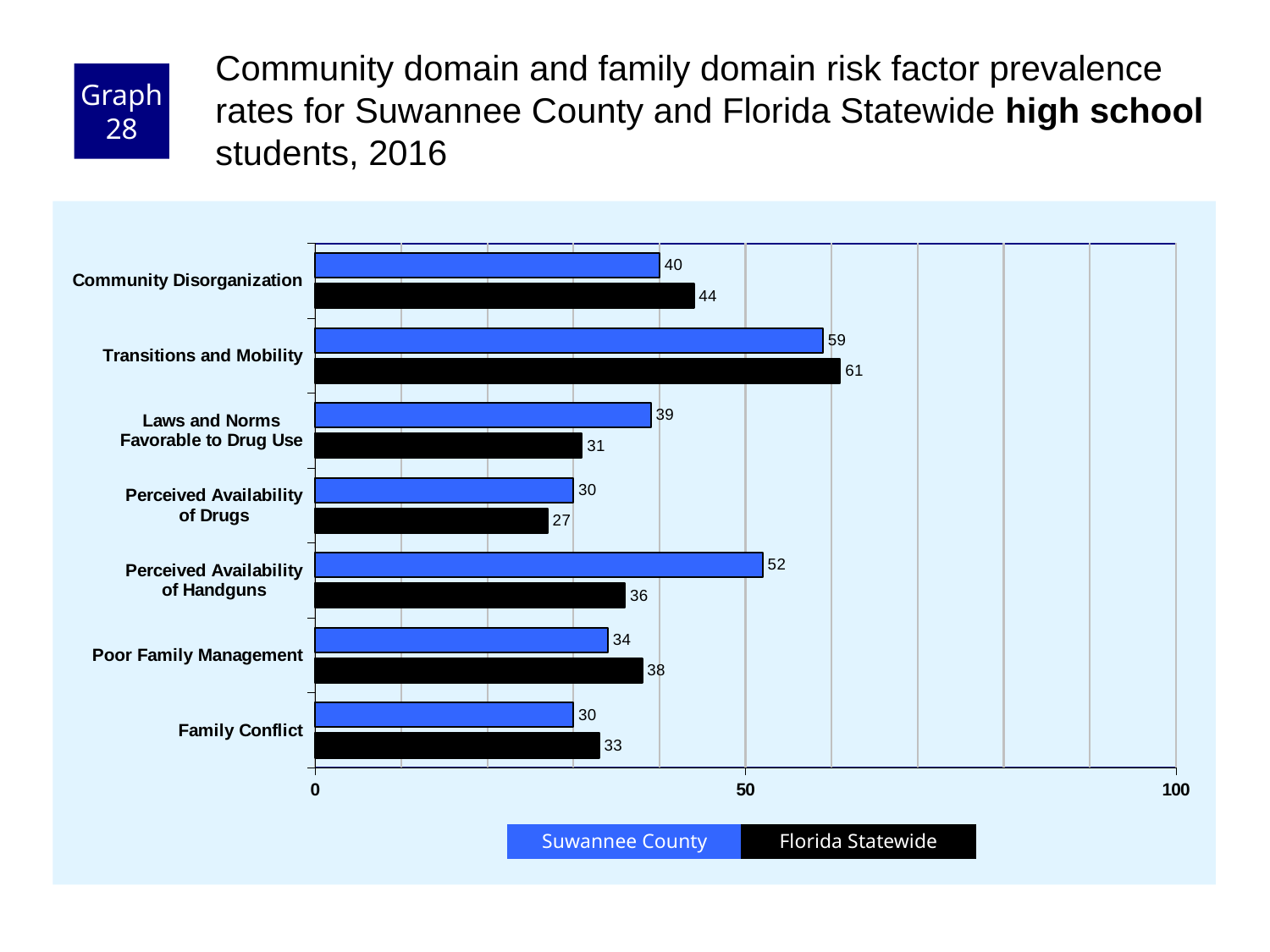
Which risk factor has the highest Florida Statewide value? Transitions and Mobility What kind of chart is shown on the slide? Bar chart How many series does the legend list? 2 What is the Florida Statewide value for Community Disorganization? 44 How many risk factors are shown on the chart? 7 What is the Florida Statewide value for Perceived Availability of Handguns? 36 Is the Suwannee County value for Transitions and Mobility greater or less than 50? greater What is the difference between the Suwannee County and Florida Statewide values for Perceived Availability of Handguns? 16 Which risk factor has the lowest Florida Statewide value? Perceived Availability of Drugs Which colour represents Florida Statewide in the chart? Black Which is larger for Laws and Norms Favorable to Drug Use: the Suwannee County value or the Florida Statewide value? Suwannee County What is the Suwannee County value for Transitions and Mobility? 59